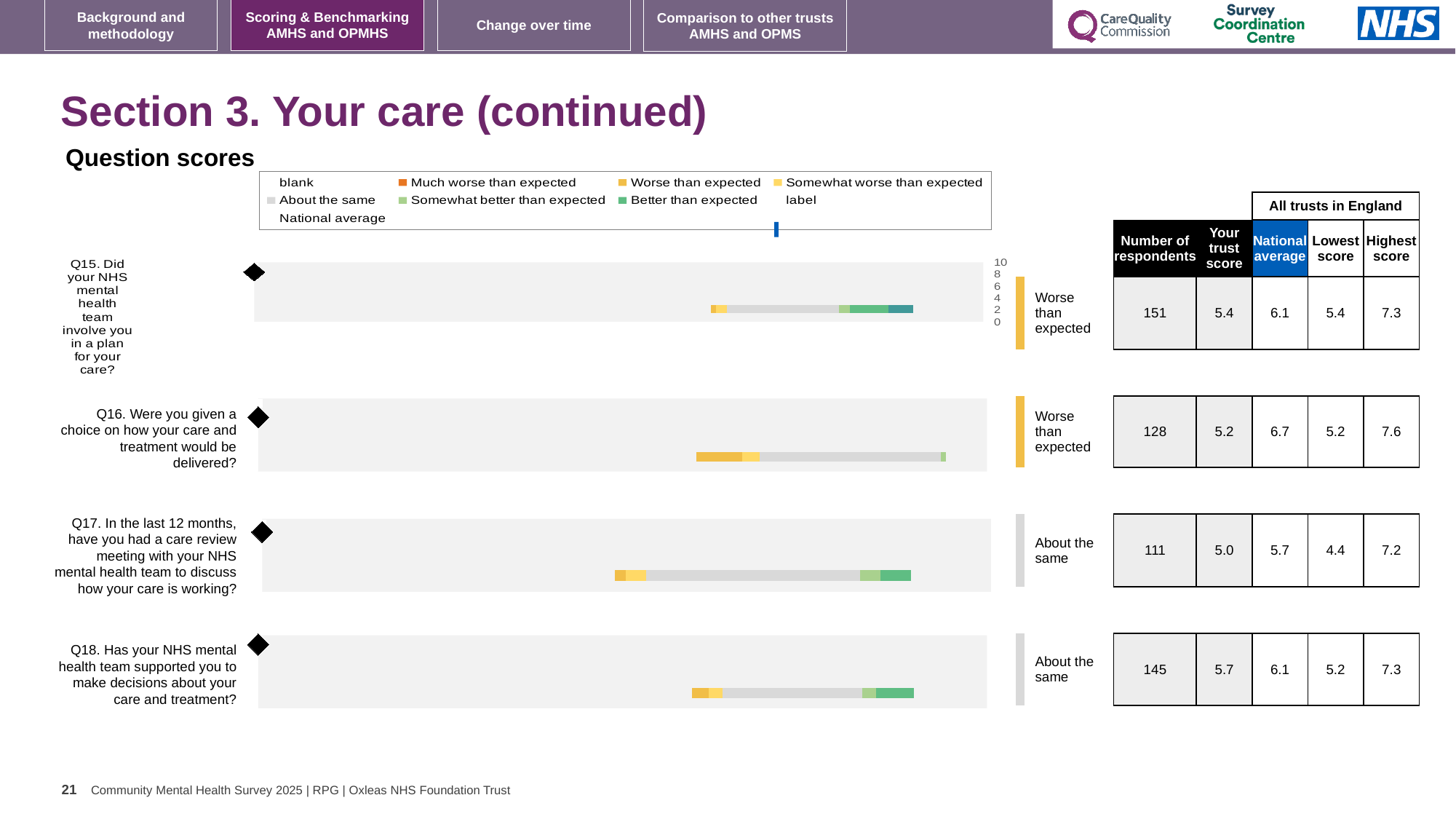
Which question has the lowest 'Your trust score' on the slide? Q17 Which question has the highest 'Your trust score' on the slide? Q18 What is the highest score among all trusts in England for Q18 (supported you to make decisions about your care and treatment)? 7.3 What benchmark rating is shown next to the bar for Q15? Worse than expected What is the national average score for Q16 (Were you given a choice on how your care and treatment would be delivered?)? 6.7 For Q15, which is larger: the trust score or the national average? national average How many survey questions (bars) are plotted on the slide? 4 How many of the four questions are rated 'About the same'? 2 For Q16, what is the difference between the national average and the trust score? 1.5 How many respondents answered Q17 (care review meeting in the last 12 months)? 111 What is the 'Your trust score' value for Q15 (Did your NHS mental health team involve you in a plan for your care?)? 5.4 What kind of chart is used to show the question scores for Q15 to Q18? bar chart